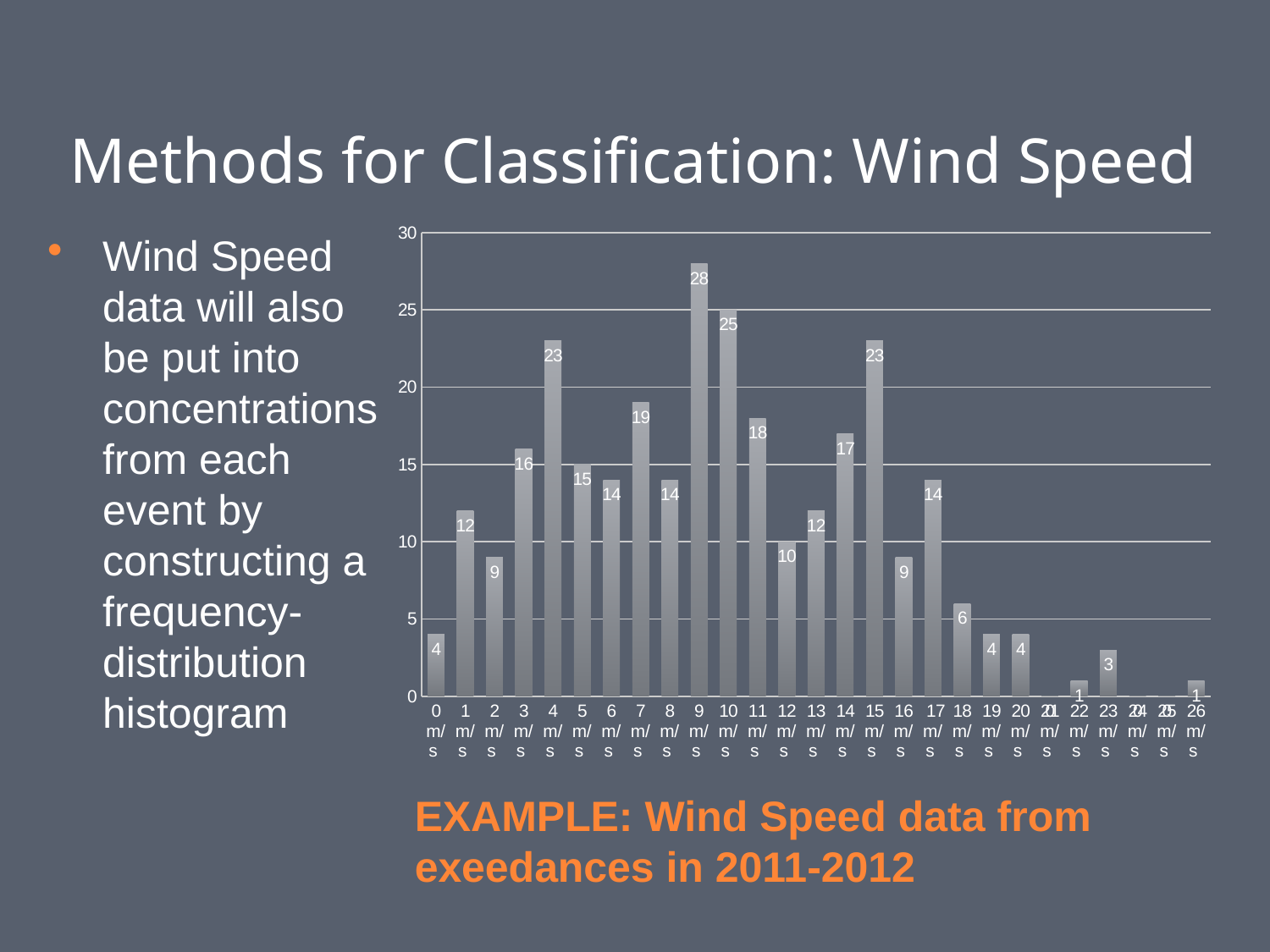
Is the value for 12 m/s greater or less than 15? less What is the value for 4 m/s? 23 Which wind speed category has the highest value? 9 m/s What is the value for 9 m/s? 28 What is the difference between the values for 15 m/s and 16 m/s? 14 What is the value for 18 m/s? 6 Which is larger, the value for 7 m/s or the value for 11 m/s? 7 m/s What is the caption shown below the chart? EXAMPLE: Wind Speed data from exeedances in 2011-2012 What is the value for 0 m/s? 4 What kind of chart is shown on the slide? bar chart What is the difference between the values for 9 m/s and 10 m/s? 3 Which is larger, the value for 3 m/s or the value for 14 m/s? 14 m/s